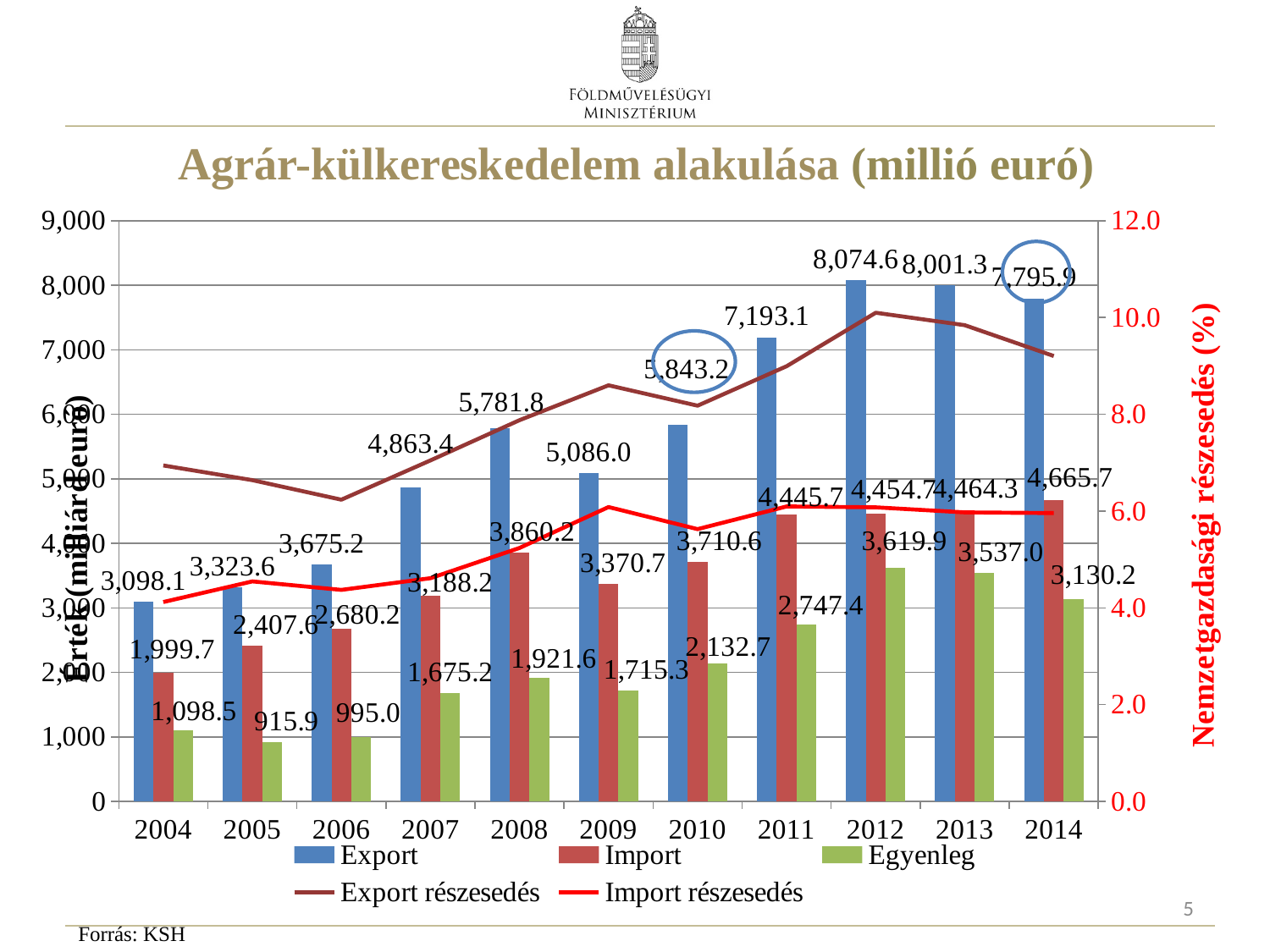
Does the Export value rise or fall from 2010 to 2012? rise What is the difference between the Export values for 2013 and 2014? 205.4 Is the Export részesedés value for 2012 greater or less than 8.0 on the right axis? greater In which year is the Export value highest? 2012 Which is larger, the Import value for 2011 or the Import value for 2014? 2014 How many series does the legend list? 5 How many years are shown on the x axis? 11 What is the Egyenleg value for 2014? 3,130.2 What is the Export value for 2012? 8,074.6 What is the difference between the Export and Import values in 2012? 3,619.9 In which year is the Egyenleg value lowest? 2005 What is the Import value for 2008? 3,860.2